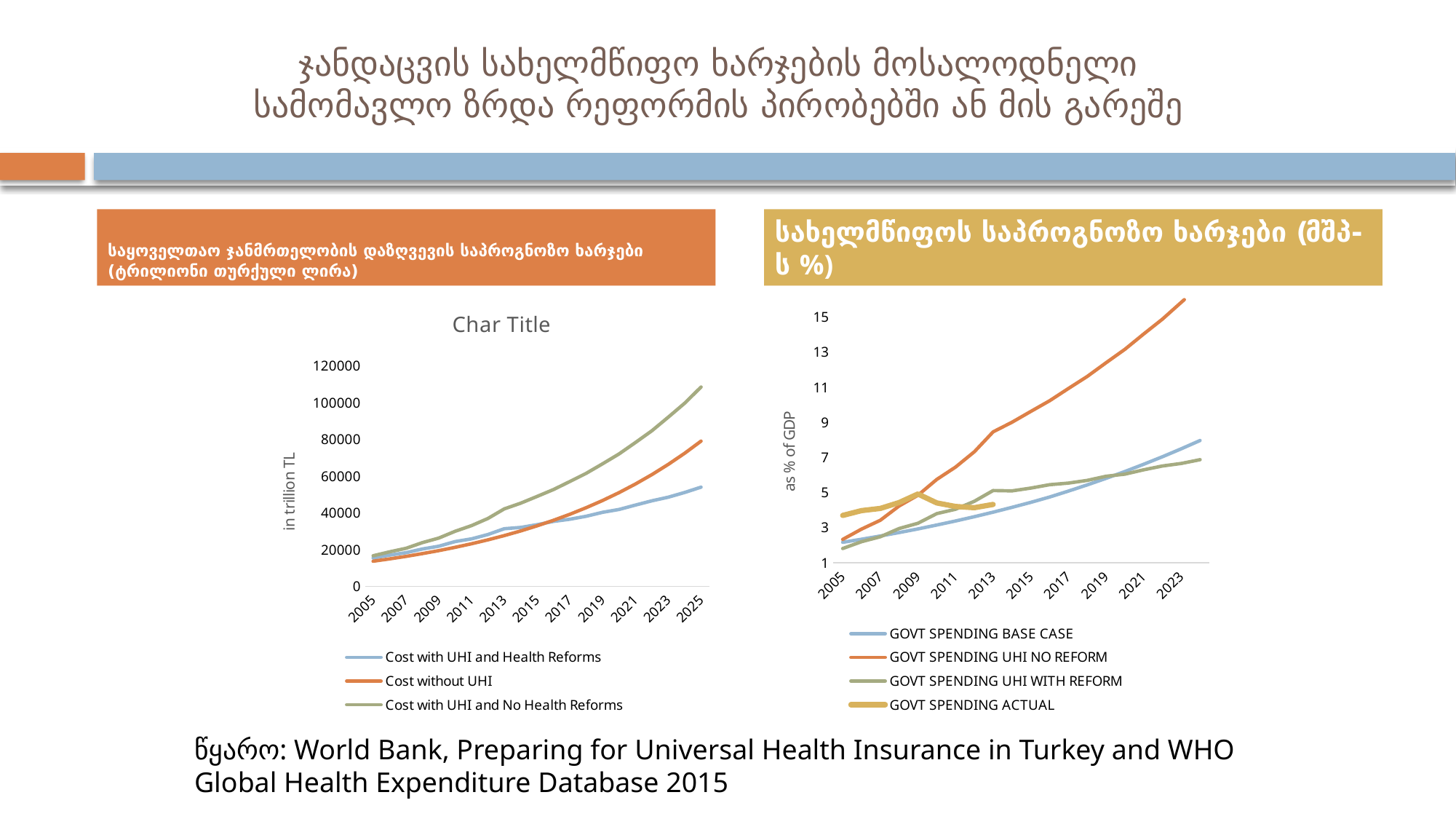
In the right chart (as % of GDP), is the value for GOVT SPENDING UHI NO REFORM in 2023 greater or less than 15? greater How many series does the legend of the left chart ("Char Title") list? 3 In the right chart (as % of GDP), is the value for GOVT SPENDING ACTUAL in 2013 greater or less than 5? less What kind of chart is the left chart titled "Char Title"? line chart In the left chart ("Char Title"), is the value for Cost with UHI and Health Reforms in 2025 greater or less than 60000? less In the left chart ("Char Title"), which series has the highest value in 2025? Cost with UHI and No Health Reforms What is the y-axis label of the left chart ("Char Title")? in trillion TL In the left chart ("Char Title"), which series has the lowest value in 2025? Cost with UHI and Health Reforms In the right chart (as % of GDP), do the values for GOVT SPENDING UHI NO REFORM rise or fall from 2005 to 2023? rise In the right chart (as % of GDP), which series has the highest value in 2023? GOVT SPENDING UHI NO REFORM How many series does the legend of the right chart (as % of GDP) list? 4